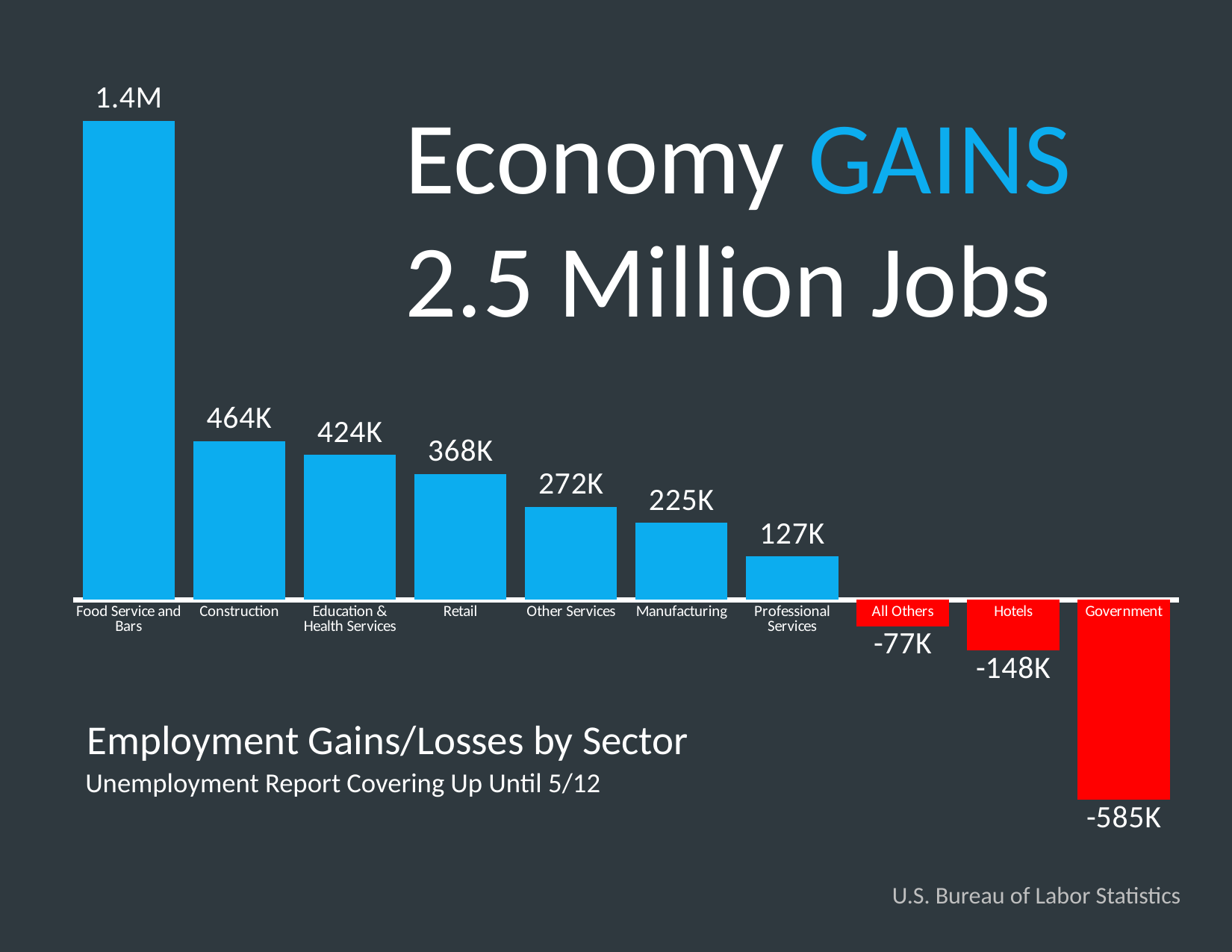
Which sector has the highest value? Food Service and Bars Which is larger, the value for Retail or the value for Other Services? Retail What is the value for Hotels? -148K What is the difference between the values for Construction and Education & Health Services? 40K Which sector has the lowest value? Government What is the difference between the values for Other Services and Manufacturing? 47K What is the value for Construction? 464K What is the title of the chart? Employment Gains/Losses by Sector How many sectors are shown in the chart? 10 What kind of chart is shown on the slide? Bar chart What is the value for Retail? 368K What is the value for Government? -585K